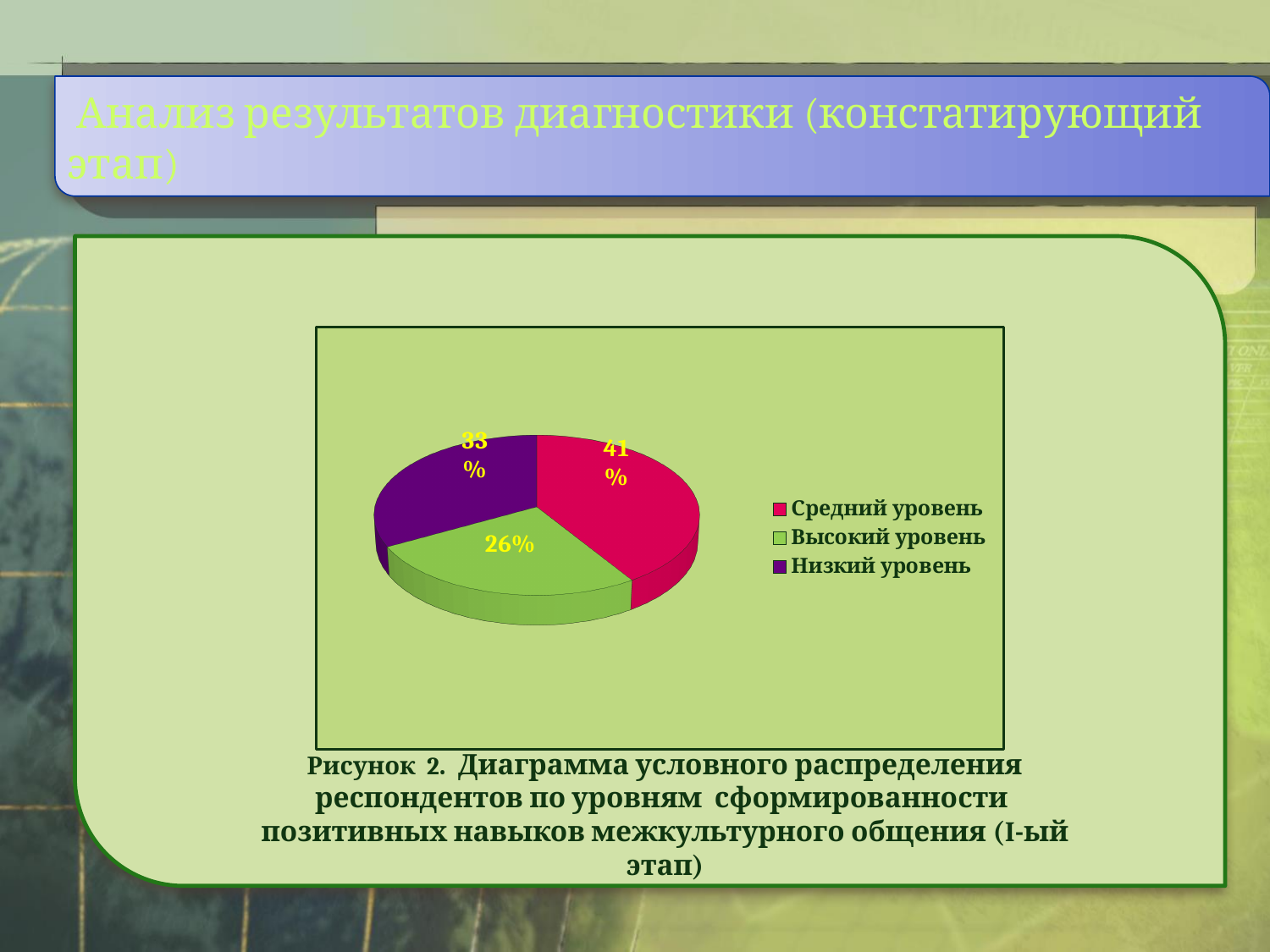
How many entries does the legend list? 3 What is the difference in percentage points between "Низкий уровень" and "Высокий уровень"? 7 Which level has the largest slice of the pie? Средний уровень Which is larger, the slice for "Низкий уровень" or the slice for "Высокий уровень"? Низкий уровень What share of the pie does "Высокий уровень" have? 26% What kind of chart is shown on the slide? pie chart What colour is the slice for "Низкий уровень"? purple How many slices does the pie chart have? 3 Which level has the smallest slice of the pie? Высокий уровень What share of the pie does "Низкий уровень" have? 33% What is the difference in percentage points between "Средний уровень" and "Высокий уровень"? 15 What share of the pie does "Средний уровень" have? 41%